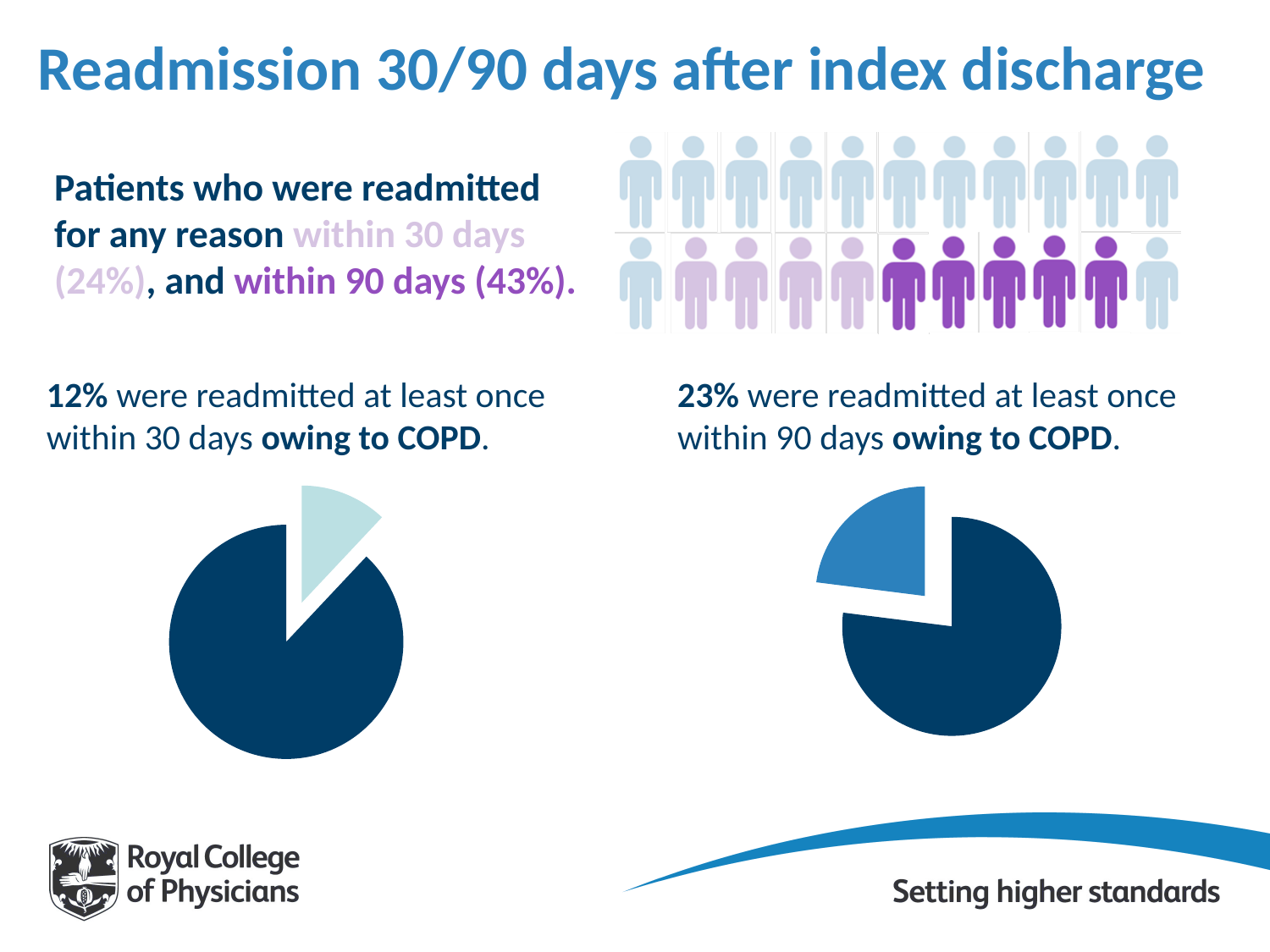
According to the pictogram text, what percentage of patients were readmitted for any reason within 30 days? 24% In the left pie chart, what percentage of patients were readmitted at least once within 30 days owing to COPD? 12% What is the difference in percentage points between readmission for any reason within 90 days and within 30 days? 19 percentage points What is the title of the slide containing the pie charts? Readmission 30/90 days after index discharge In the right pie chart, what percentage of patients were readmitted at least once within 90 days owing to COPD? 23% In the right pie chart, what colour is the exploded 23% slice? blue What is the difference in percentage points between the 90-day COPD readmission share (right pie) and the 30-day COPD readmission share (left pie)? 11 percentage points According to the pictogram text, what percentage of patients were readmitted for any reason within 90 days? 43% In the left pie chart, what share of the pie is taken by patients not readmitted within 30 days owing to COPD? 88% How many pie charts are shown on the slide? 2 What kind of chart is used to show the 12% and 23% COPD readmission figures? pie chart Which is larger: the share readmitted within 30 days owing to COPD (left pie) or within 90 days owing to COPD (right pie)? within 90 days (23%)